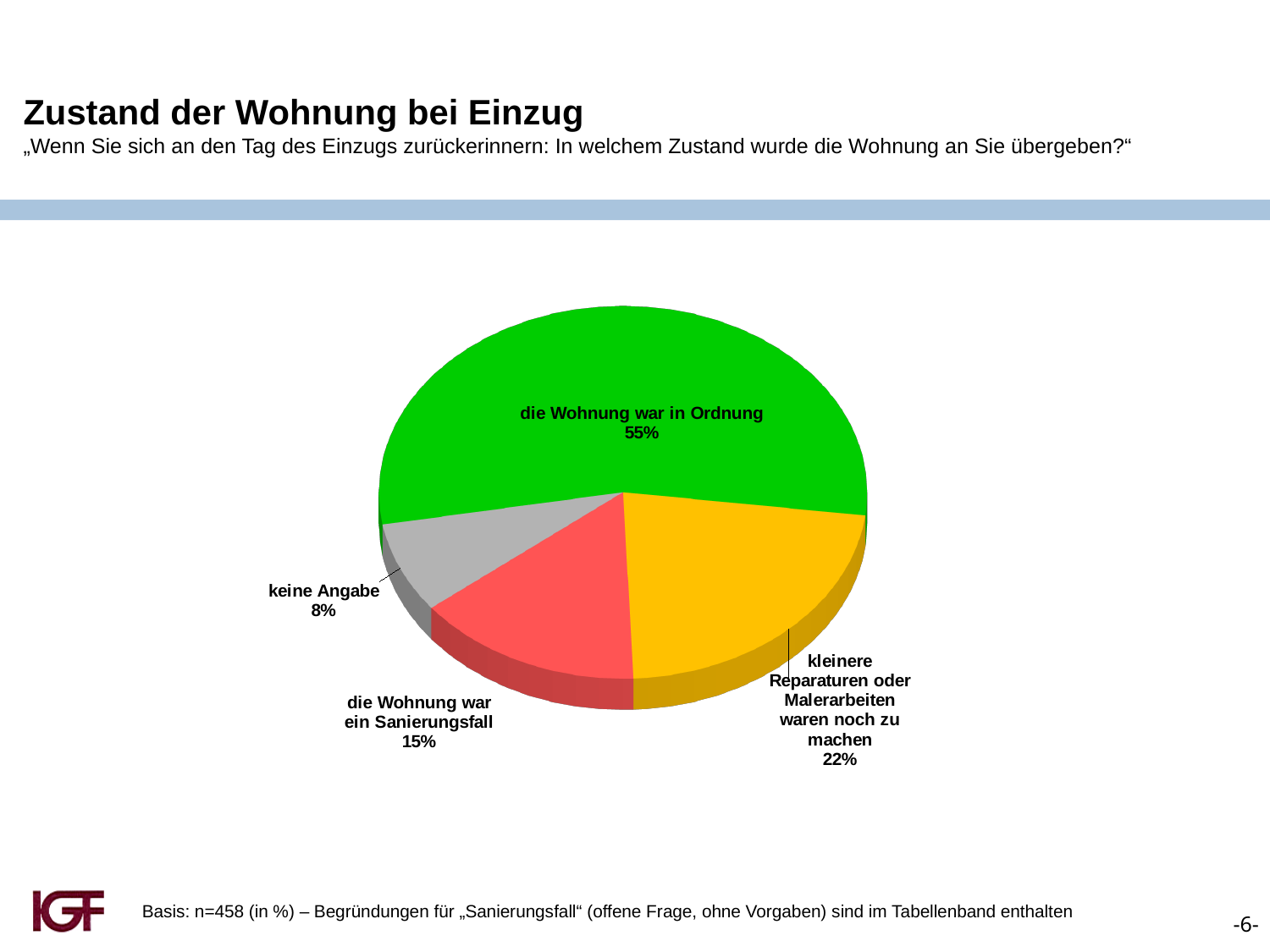
What share is shown for "kleinere Reparaturen oder Malerarbeiten waren noch zu machen"? 22% How many slices does the pie chart have? 4 What percentage is shown for "keine Angabe"? 8% What colour is the slice for "die Wohnung war in Ordnung"? green Which category has the largest slice of the pie? die Wohnung war in Ordnung Which category has the smallest slice of the pie? keine Angabe What is the difference in percentage points between "die Wohnung war in Ordnung" and "kleinere Reparaturen oder Malerarbeiten waren noch zu machen"? 33 percentage points What kind of chart is shown on the slide? pie chart What share is shown for "die Wohnung war ein Sanierungsfall"? 15% What is the title of the slide containing the pie chart? Zustand der Wohnung bei Einzug Which is larger: the share for "die Wohnung war ein Sanierungsfall" or the share for "keine Angabe"? die Wohnung war ein Sanierungsfall What percentage of respondents said "die Wohnung war in Ordnung"? 55%